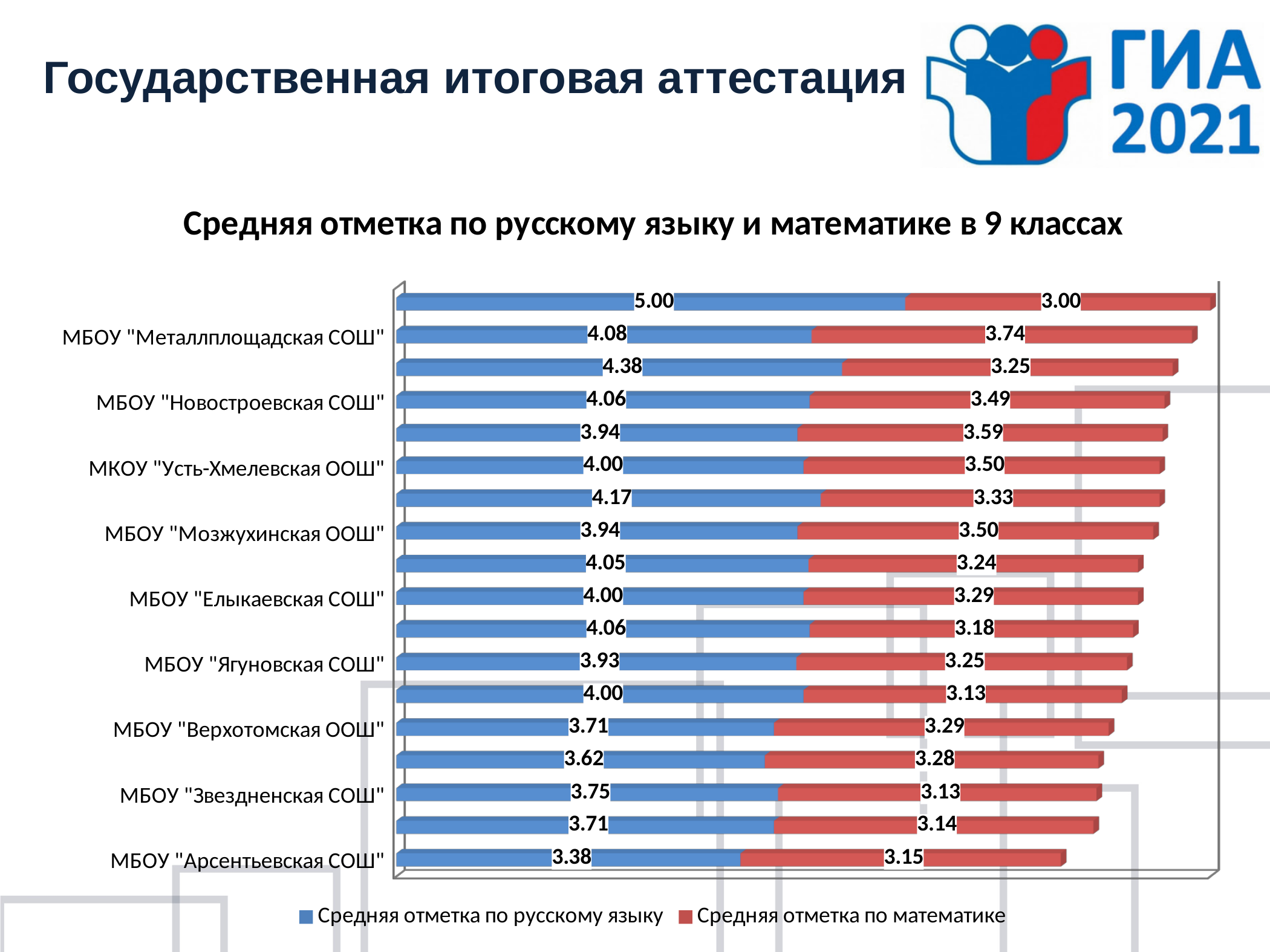
What is the total of the stacked bar for МБОУ "Металлплощадская СОШ"? 7.82 What is the average mark in mathematics for МБОУ "Звездненская СОШ"? 3.13 Which is larger: the mathematics average mark for МБОУ "Новостроевская СОШ" or for МБОУ "Елыкаевская СОШ"? МБОУ "Новостроевская СОШ" What is the average mark in Russian language for МБОУ "Арсентьевская СОШ"? 3.38 What kind of chart is shown on the slide? Stacked bar chart What is the difference between the Russian language and mathematics average marks for МБОУ "Новостроевская СОШ"? 0.57 What is the average mark in mathematics for МБОУ "Новостроевская СОШ"? 3.49 What is the title of the chart? Средняя отметка по русскому языку и математике в 9 классах Which labelled school has the highest average mark in mathematics? МБОУ "Металлплощадская СОШ" What is the average mark in Russian language for МБОУ "Металлплощадская СОШ"? 4.08 Which school has the lowest average mark in Russian language? МБОУ "Арсентьевская СОШ" How many series does the legend list? 2